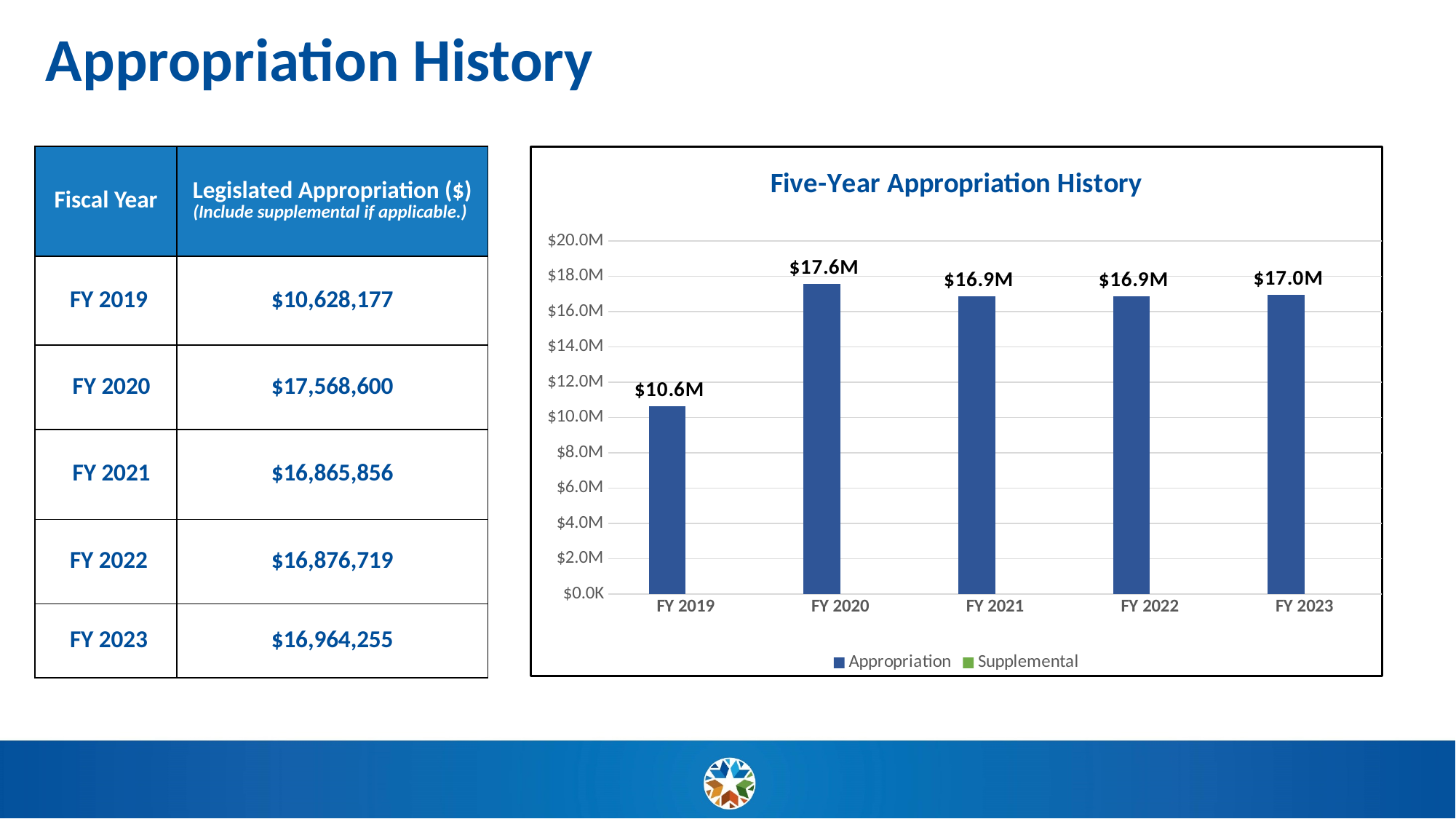
What is the value for FY 2023 in the Five-Year Appropriation History chart? $17.0M Is the value for FY 2019 greater or less than $12.0M? less Which fiscal year has the highest appropriation in the chart? FY 2020 Which fiscal year has the lowest appropriation in the chart? FY 2019 How many series does the chart legend list? 2 What is the value for FY 2020 in the Five-Year Appropriation History chart? $17.6M What kind of chart is shown on the slide? bar chart What is the title of the chart on the slide? Five-Year Appropriation History What is the value for FY 2019 in the Five-Year Appropriation History chart? $10.6M How many fiscal years are shown on the x axis of the chart? 5 What is the difference between the FY 2020 and FY 2019 values shown in the chart? $7.0M Which is larger in the chart, the value for FY 2020 or the value for FY 2023? FY 2020